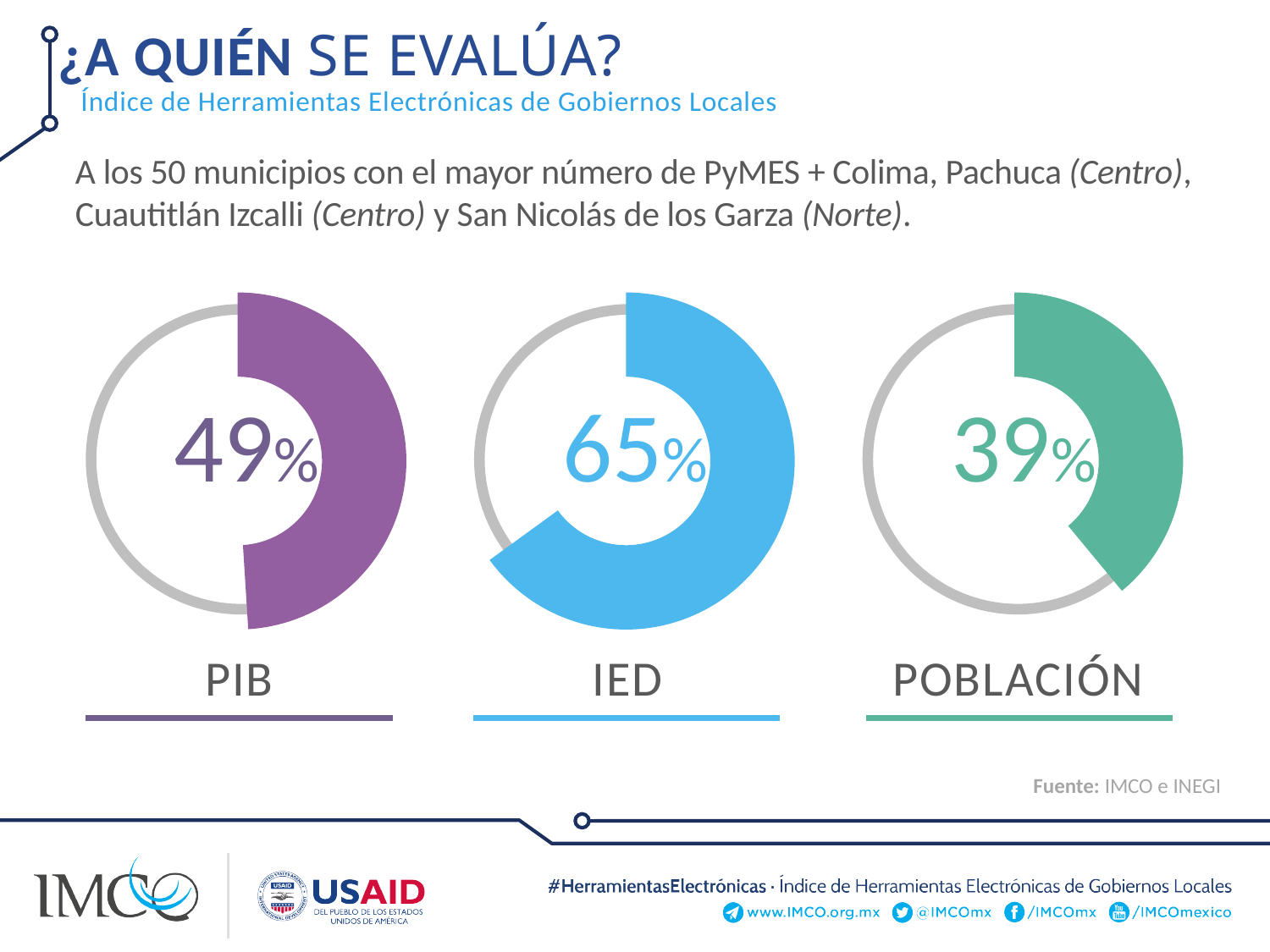
What colour is the filled portion of the IED chart? Blue What is the difference between the IED percentage and the PIB percentage? 16% Which is larger, the PIB percentage or the POBLACIÓN percentage? PIB Which of the three charts (PIB, IED, POBLACIÓN) shows the lowest percentage? POBLACIÓN How many donut charts are shown on the slide? 3 Which of the three charts (PIB, IED, POBLACIÓN) shows the highest percentage? IED What is the difference between the PIB percentage and the POBLACIÓN percentage? 10% What kind of chart is used to show the PIB, IED and POBLACIÓN percentages? Donut chart What source is cited for the charts on the slide? IMCO e INEGI What percentage is shown in the PIB chart? 49% What percentage is shown in the POBLACIÓN chart? 39% What percentage is shown in the IED chart? 65%